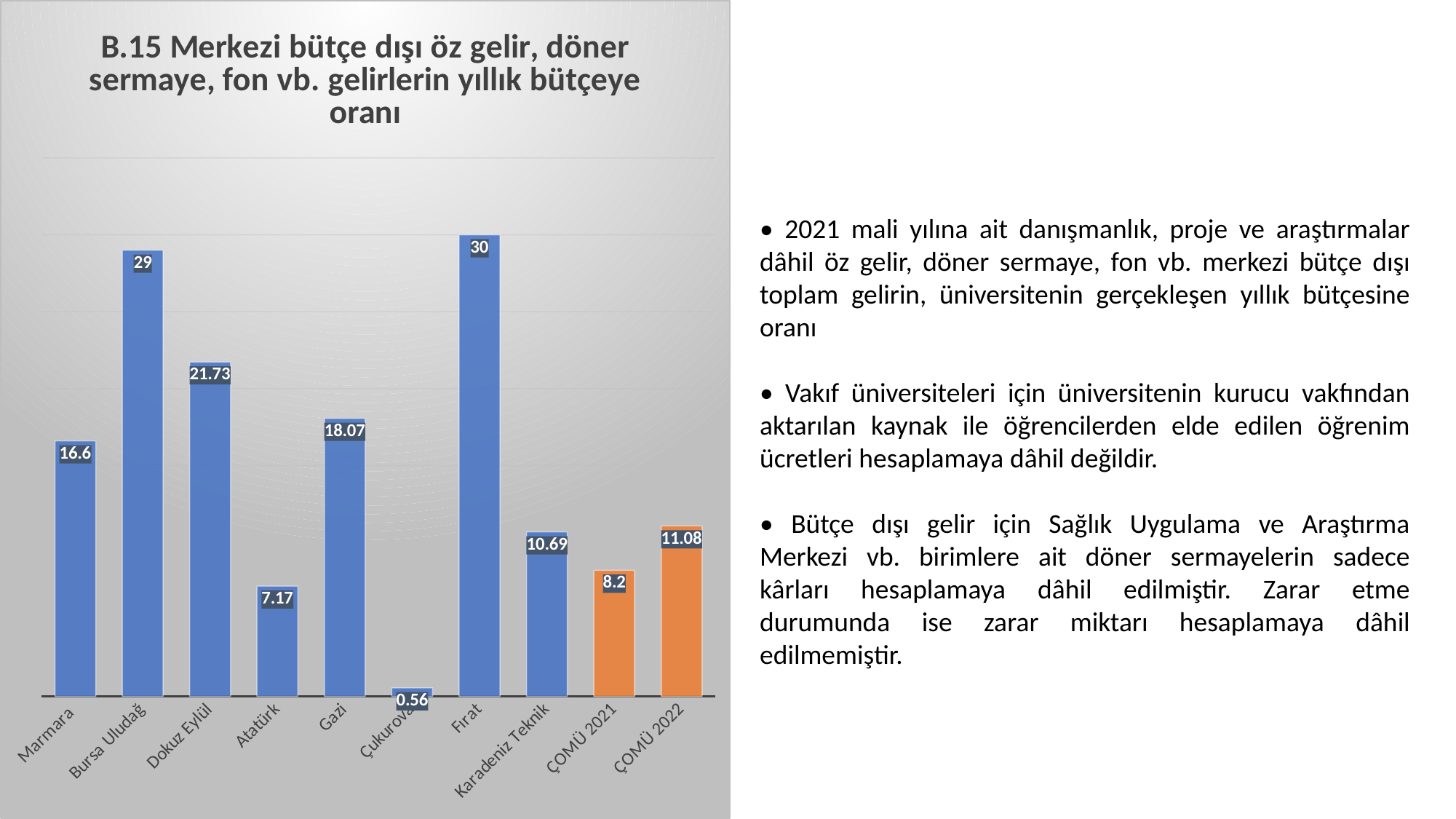
What is the difference between the values for Bursa Uludağ and Gazi? 10.93 How many categories are shown on the x axis? 10 What kind of chart is this? bar chart Which category has the lowest value? Çukurova What is the difference between the values for ÇOMÜ 2022 and ÇOMÜ 2021? 2.88 Which is larger, the value for Karadeniz Teknik or the value for Atatürk? Karadeniz Teknik What is the title of the chart? B.15 Merkezi bütçe dışı öz gelir, döner sermaye, fon vb. gelirlerin yıllık bütçeye oranı Which category has the highest value? Fırat Which categories are shown with orange bars? ÇOMÜ 2021 and ÇOMÜ 2022 What is the value for Dokuz Eylül? 21.73 What is the value for Marmara? 16.6 What is the value for ÇOMÜ 2022? 11.08